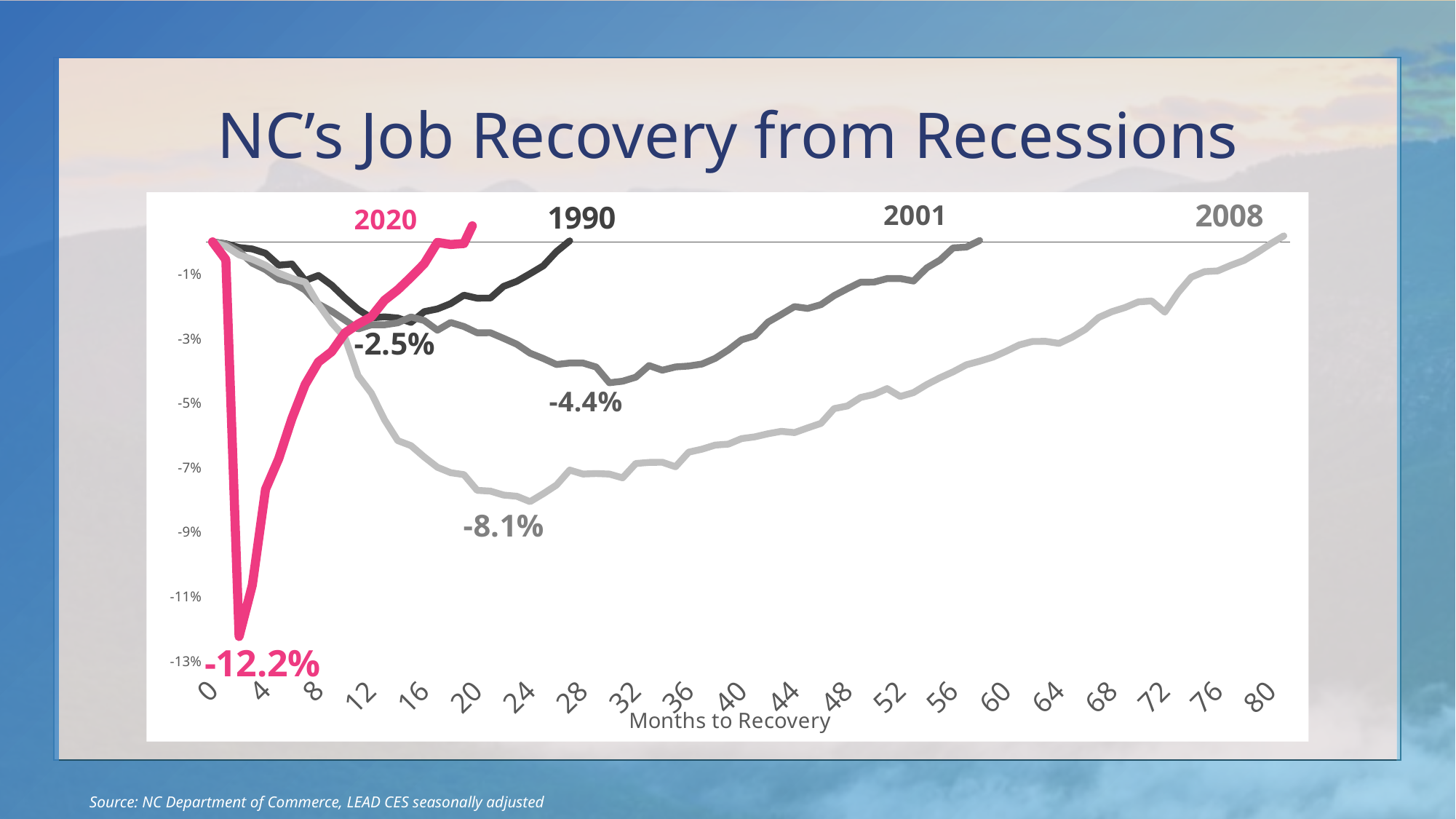
How many recessions (series) are plotted on the chart? 4 What was the lowest point of job loss for the 2001 recession? -4.4% What kind of chart is shown on the slide? line chart Did the 2001 recession take greater or less than 40 months to recover? greater Which recession had the smallest job loss at its lowest point? 1990 What is the difference between the lowest points of the 2008 and 2001 recessions? 3.7 percentage points What was the lowest point of job loss for the 1990 recession? -2.5% What was the lowest point of job loss for the 2008 recession? -8.1% What is the label of the x axis? Months to Recovery Which recession had the deepest job loss? 2020 Which recession had a deeper job loss, 2020 or 2008? 2020 What was the lowest point of job loss for the 2020 recession? -12.2%